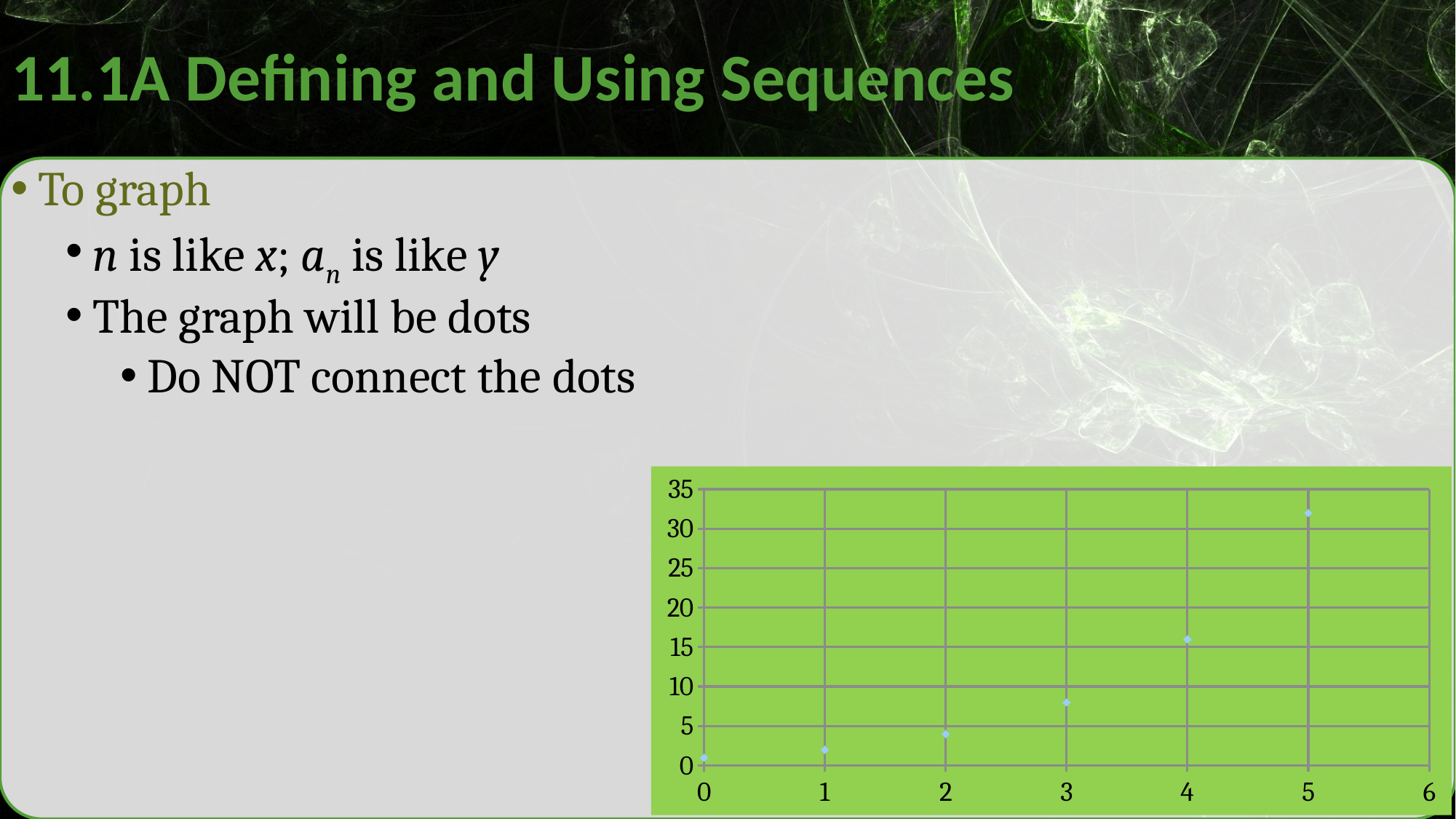
Is the value of the point at x = 2 greater or less than 5? less How many data points are plotted on the chart? 6 Is the value of the point at x = 5 greater or less than 30? greater What kind of chart is shown on the slide? scatter chart At which x value is the plotted point highest? 5 What is the highest value shown on the vertical axis of the chart? 35 What is the highest value shown on the horizontal axis of the chart? 6 Do the plotted values rise or fall as x increases from 0 to 5? rise Which point has the larger value, the one at x = 4 or the one at x = 3? x = 4 Is the value of the point at x = 3 greater or less than 5? greater At which x value is the plotted point lowest? 0